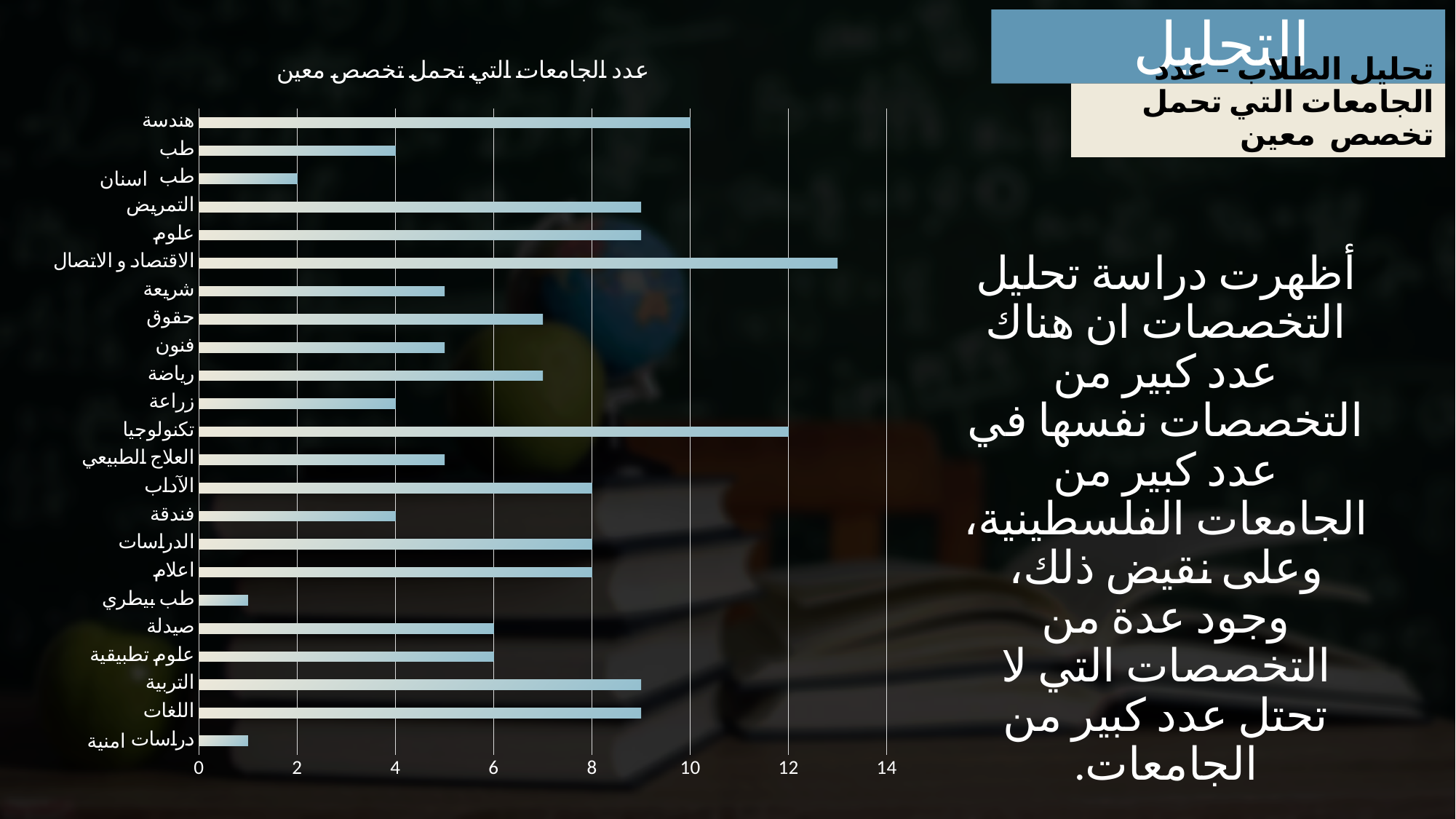
What is the title of the chart? عدد الجامعات التي تحمل تخصص معين What is the value for هندسة? 10 Is the value for طب بيطري greater or less than 2? less How many categories (specialisations) are plotted in the chart? 23 What kind of chart is shown on the slide? bar chart What is the value for طب اسنان? 2 Which category has the highest value in the chart? الاقتصاد و الاتصال What is the difference between the values for هندسة and طب? 6 What is the value for تكنولوجيا? 12 Is the value for التمريض greater or less than 8? greater Which has the larger value, حقوق or شريعة? حقوق Is the value for الاقتصاد و الاتصال greater or less than 12? greater